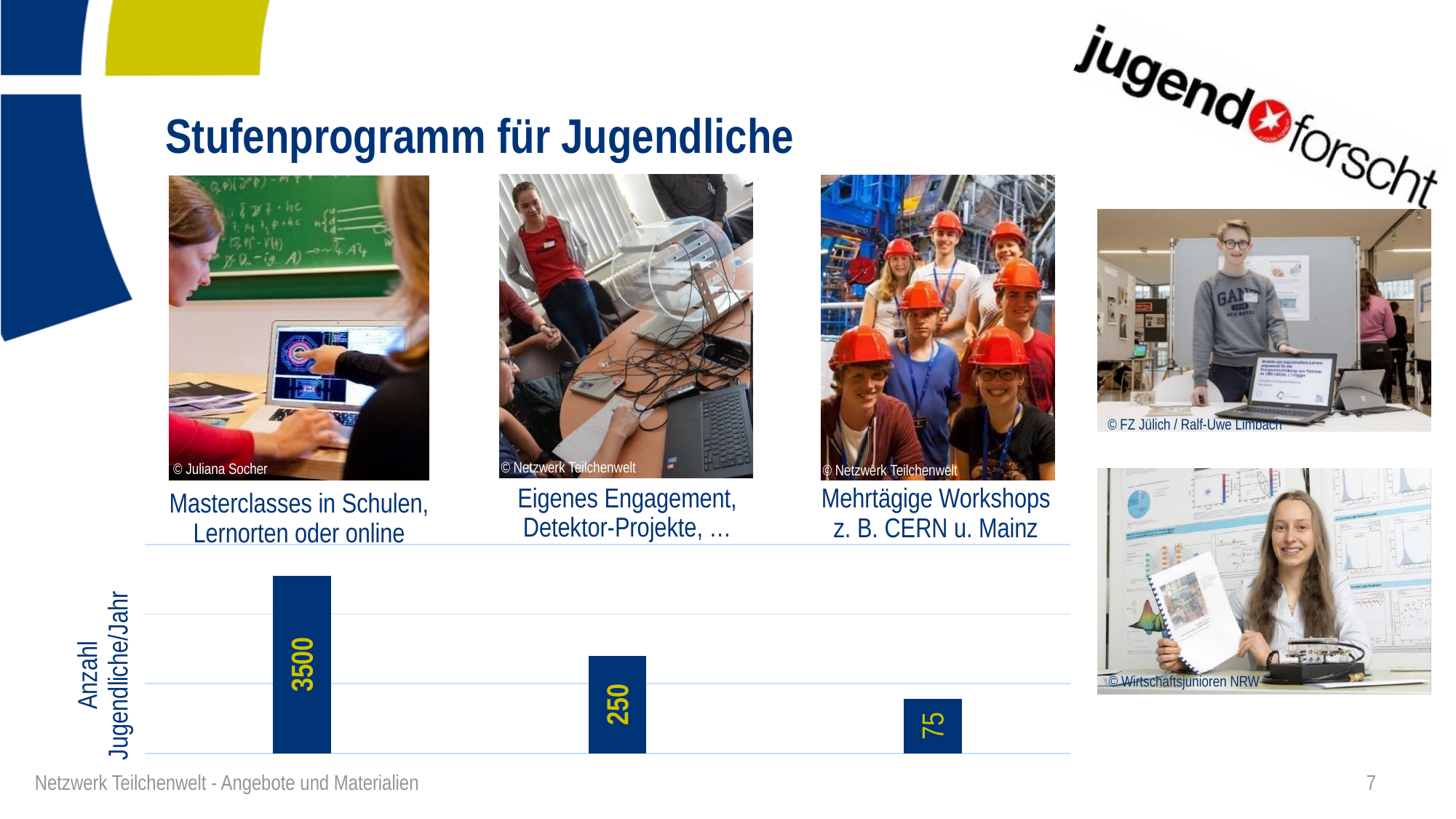
What is the difference between the values for Eigenes Engagement and Mehrtägige Workshops? 175 Which category has the highest value in the chart? Masterclasses in Schulen, Lernorten oder online How many bars does the chart show? 3 Which category has the lowest value in the chart? Mehrtägige Workshops z. B. CERN u. Mainz What is the value of the bar for Eigenes Engagement, Detektor-Projekte? 250 What type of chart is shown at the bottom of the slide? bar chart What is the label on the vertical axis of the chart? Anzahl Jugendliche/Jahr Do the values rise or fall from left to right across the chart? fall What is the difference between the values for Masterclasses and Eigenes Engagement? 3250 What is the value of the bar for Masterclasses in Schulen, Lernorten oder online? 3500 Which is larger, the value for Eigenes Engagement or the value for Mehrtägige Workshops? Eigenes Engagement What is the value of the bar for Mehrtägige Workshops z. B. CERN u. Mainz? 75